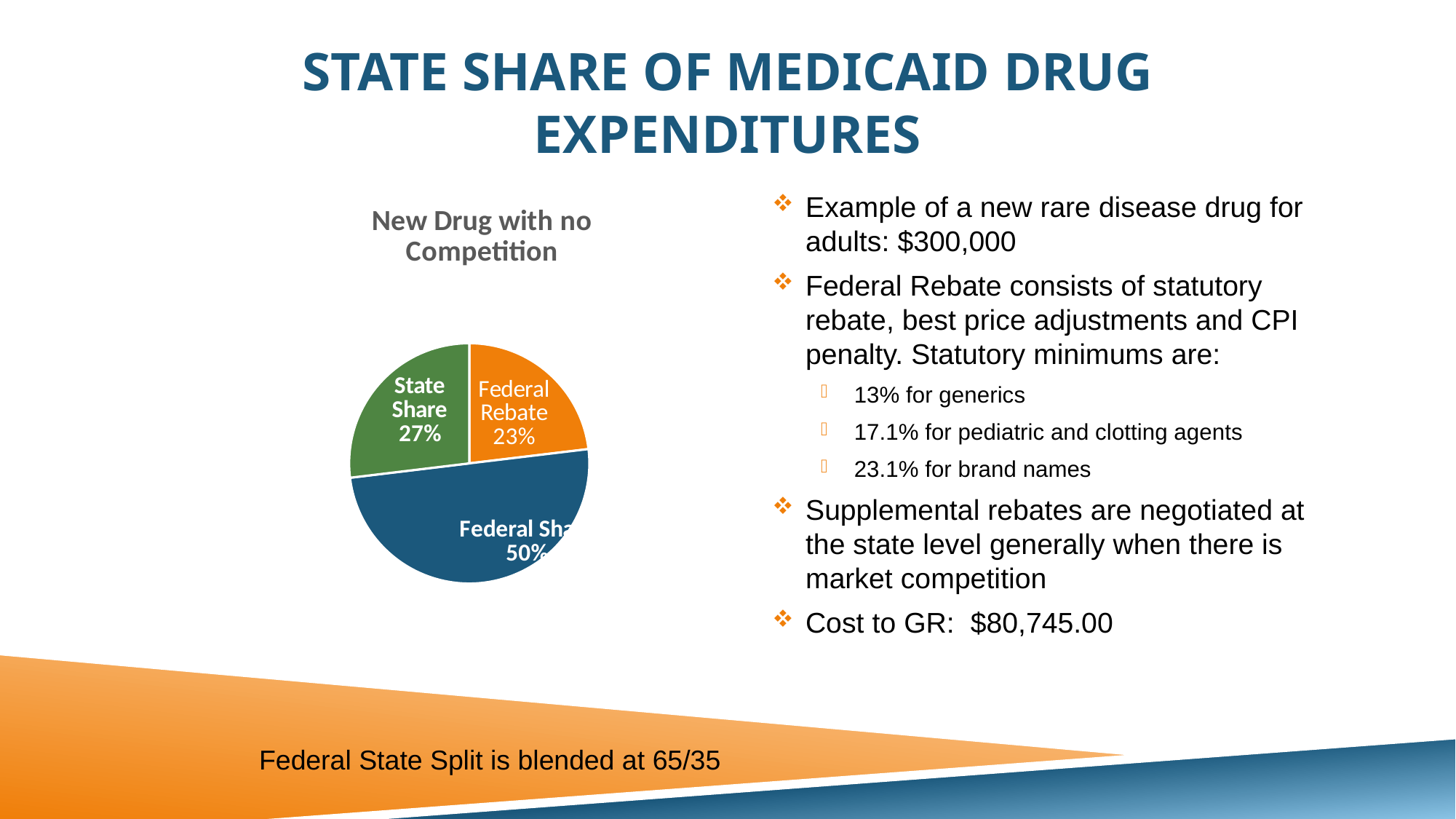
What kind of chart is shown on the slide? Pie chart What share of the pie does Federal Rebate represent? 23% Which slice of the pie is the largest? Federal Share What share of the pie does Federal Share represent? 50% What is the difference in percentage points between Federal Share and State Share? 23 What colour is the Federal Share slice? Blue What is the difference in percentage points between State Share and Federal Rebate? 4 What share of the pie does State Share represent? 27% How many slices does the pie chart have? 3 Which slice of the pie is the smallest? Federal Rebate Which is larger, State Share or Federal Rebate? State Share What is the title of the pie chart? New Drug with no Competition